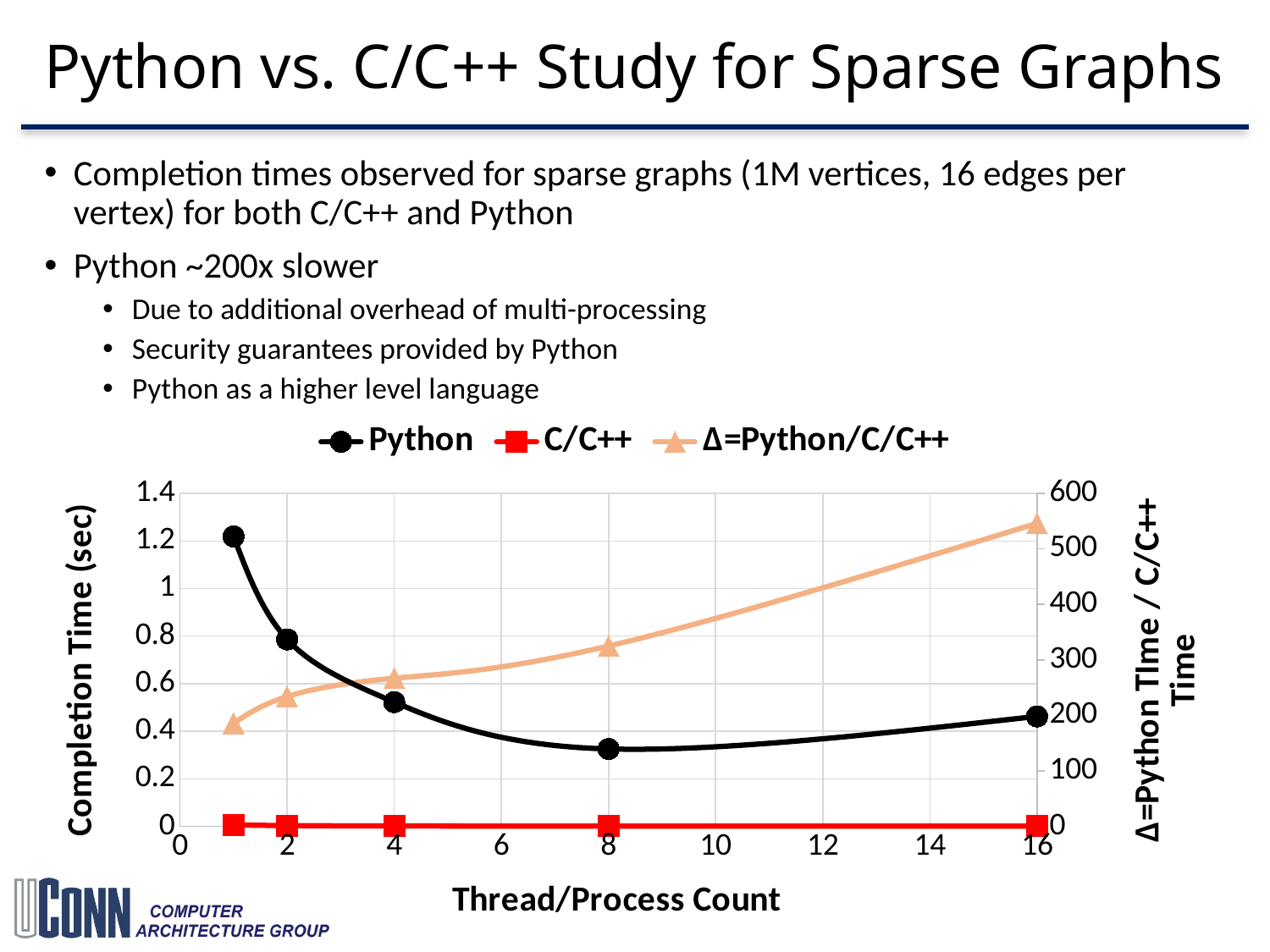
At which thread/process count is the Python completion time highest? 1 Is the Δ=Python/C/C++ value at a thread/process count of 16 greater or less than 500? greater What is the title of the x axis of the chart? Thread/Process Count How many data points are plotted for the Python series? 5 At which thread/process count is the Python completion time lowest? 8 Is the Δ=Python/C/C++ value at a thread/process count of 1 greater or less than 200? less Does the Δ=Python/C/C++ series rise or fall as the thread/process count increases? rises Is the Python completion time at a thread/process count of 8 greater or less than 0.4 seconds? less What kind of chart is shown on the slide? line chart How many series does the legend list? 3 Which has the larger Python completion time: a thread/process count of 2 or a thread/process count of 16? 2